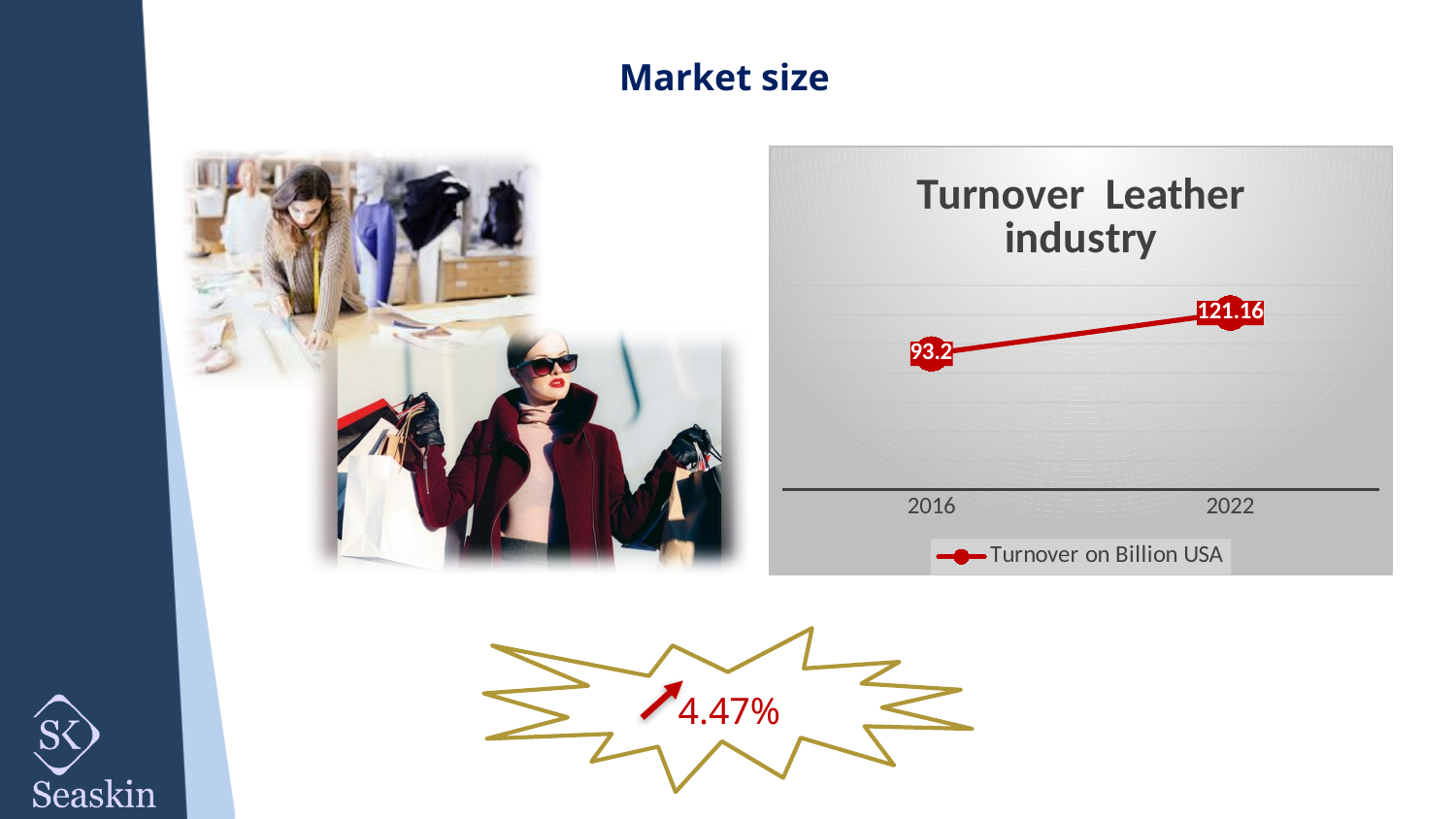
What is the title of the chart? Turnover Leather industry Which year has the lower turnover? 2016 How many data points are plotted on the chart? 2 Does the turnover rise or fall from 2016 to 2022? rise How many series does the legend list? 1 What is the turnover value for 2022? 121.16 Which year has the higher turnover? 2022 What kind of chart is shown? line chart What is the legend entry for the plotted series? Turnover on Billion USA What is the difference between the turnover in 2022 and in 2016? 27.96 What is the turnover value for 2016? 93.2 Is the turnover in 2016 larger or smaller than in 2022? smaller